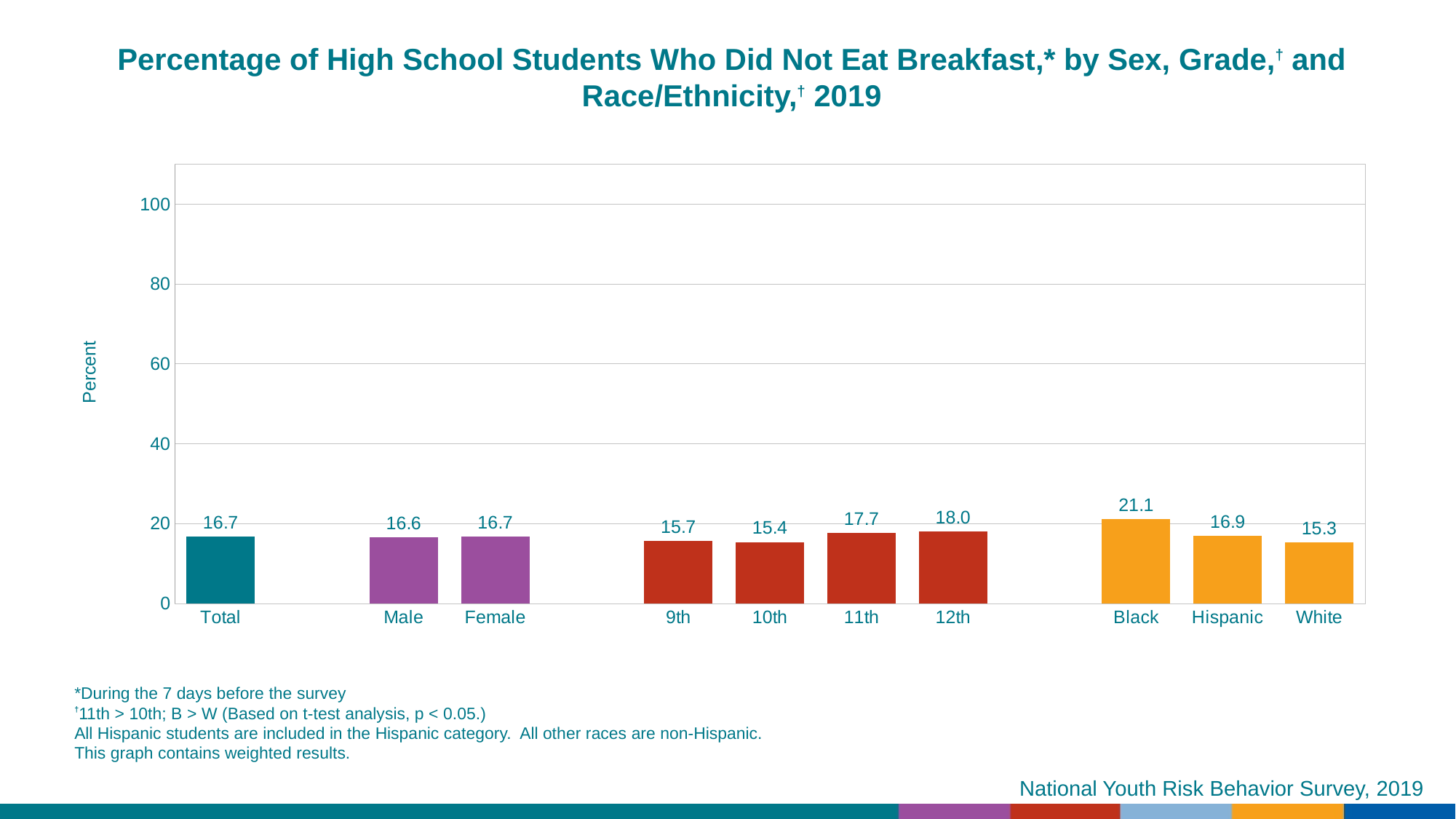
Which category has the highest value? Black What is the difference between the values for Black and White students? 5.8 What is the difference between the values for 12th grade and 9th grade? 2.3 What is the value for Total? 16.7 What percentage of Black students did not eat breakfast? 21.1 What is the label on the y axis? Percent What kind of chart is shown on the slide? bar chart Which is larger, the value for 11th grade or the value for 10th grade? 11th Which category has the lowest value? White How many categories are shown on the x axis? 10 What is the value for 10th grade students? 15.4 Is the value for Black students greater or less than 20? greater